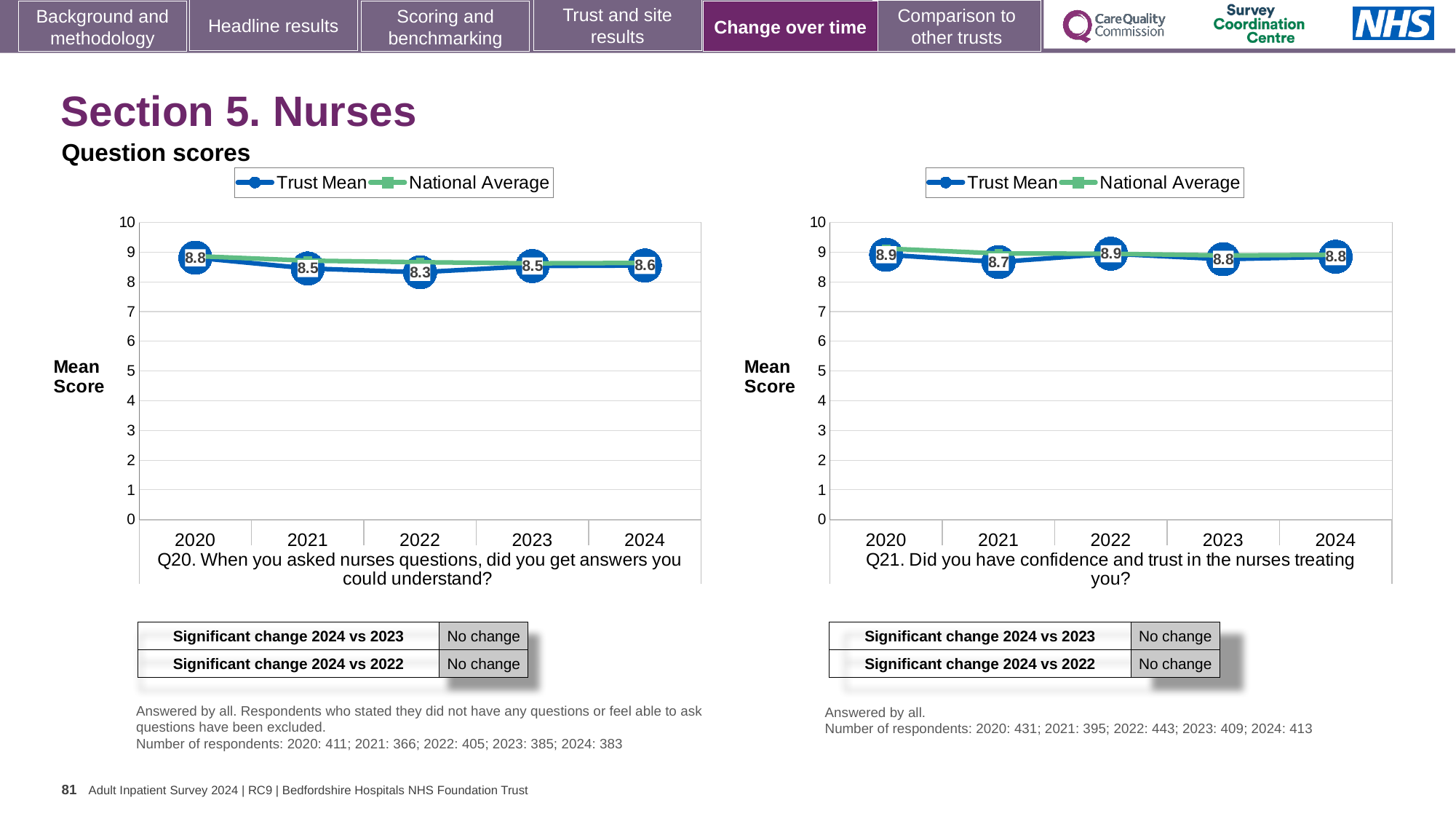
In the Q20 chart on the left, which year has the lowest Trust Mean score? 2022 In the Q21 chart on the right, which year has the lowest Trust Mean score? 2021 In the Q20 chart on the left, what is the Trust Mean score for 2022? 8.3 In the Q20 chart on the left, what is the Trust Mean score for 2020? 8.8 In the Q21 chart on the right, what is the difference between the Trust Mean scores for 2020 and 2021? 0.2 How many series does the legend of the Q20 chart on the left list? 2 In the Q21 chart on the right, is the Trust Mean score for 2022 larger or smaller than for 2021? larger In the Q21 chart on the right, what is the Trust Mean score for 2021? 8.7 In the Q21 chart on the right, is the National Average value for 2020 greater or less than 8? greater In the Q20 chart on the left, which year has the highest Trust Mean score? 2020 In the Q20 chart on the left, what is the difference between the Trust Mean scores for 2020 and 2022? 0.5 In the Q20 chart on the left, does the Trust Mean rise or fall from 2020 to 2022? fall